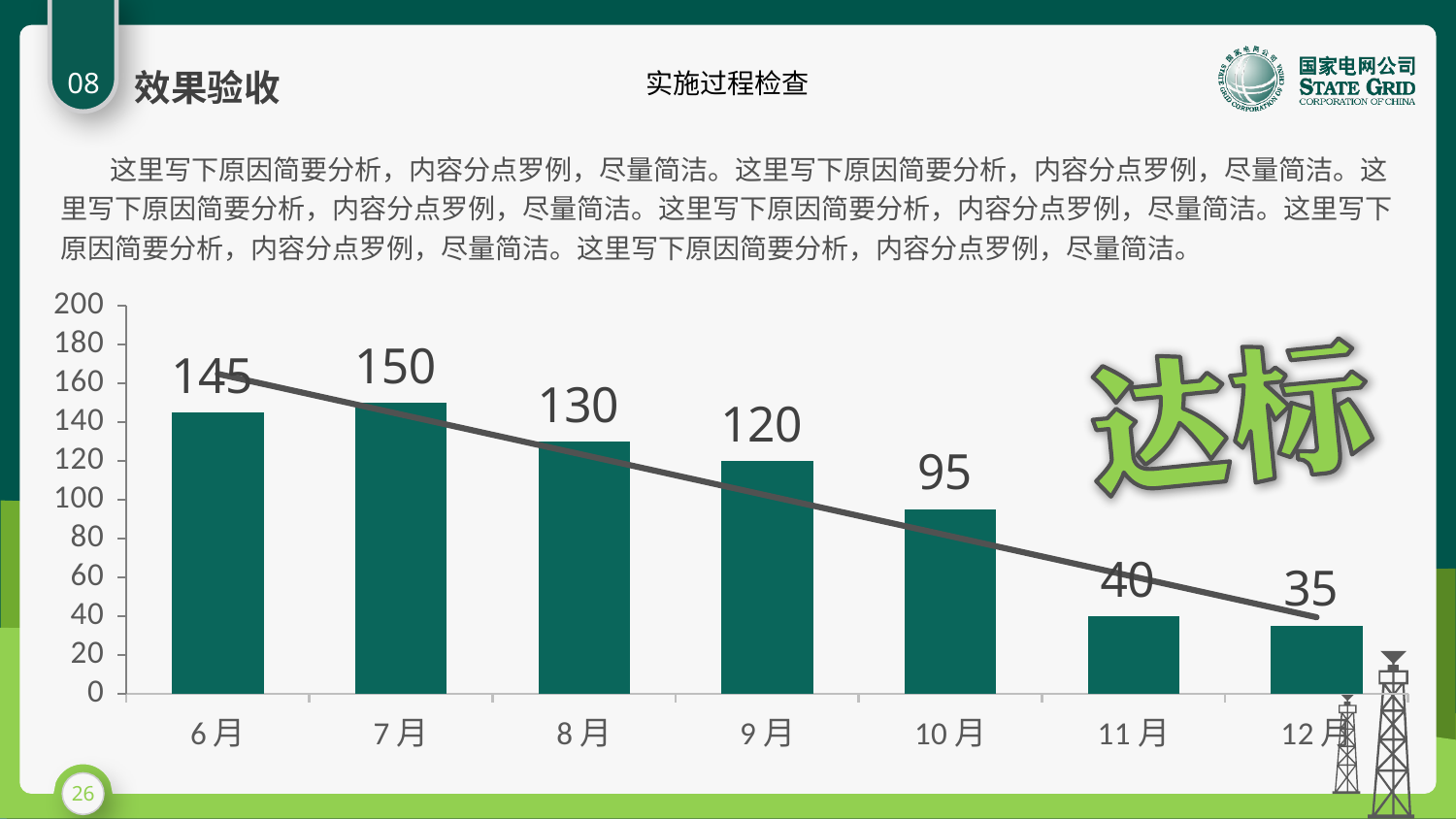
Is the value for 11月 greater or less than 60? less Which month has the lowest value? 12月 How many months are shown on the x axis? 7 What is the value for 10月? 95 What is the value for 7月? 150 Do the values generally rise or fall from 7月 to 12月? fall What is the large green text overlaid on the chart? 达标 What kind of chart is shown on the slide? bar chart Which is larger, the value for 8月 or the value for 9月? 8月 What is the difference between the values for 6月 and 11月? 105 Which month has the highest value? 7月 What is the value for 12月? 35